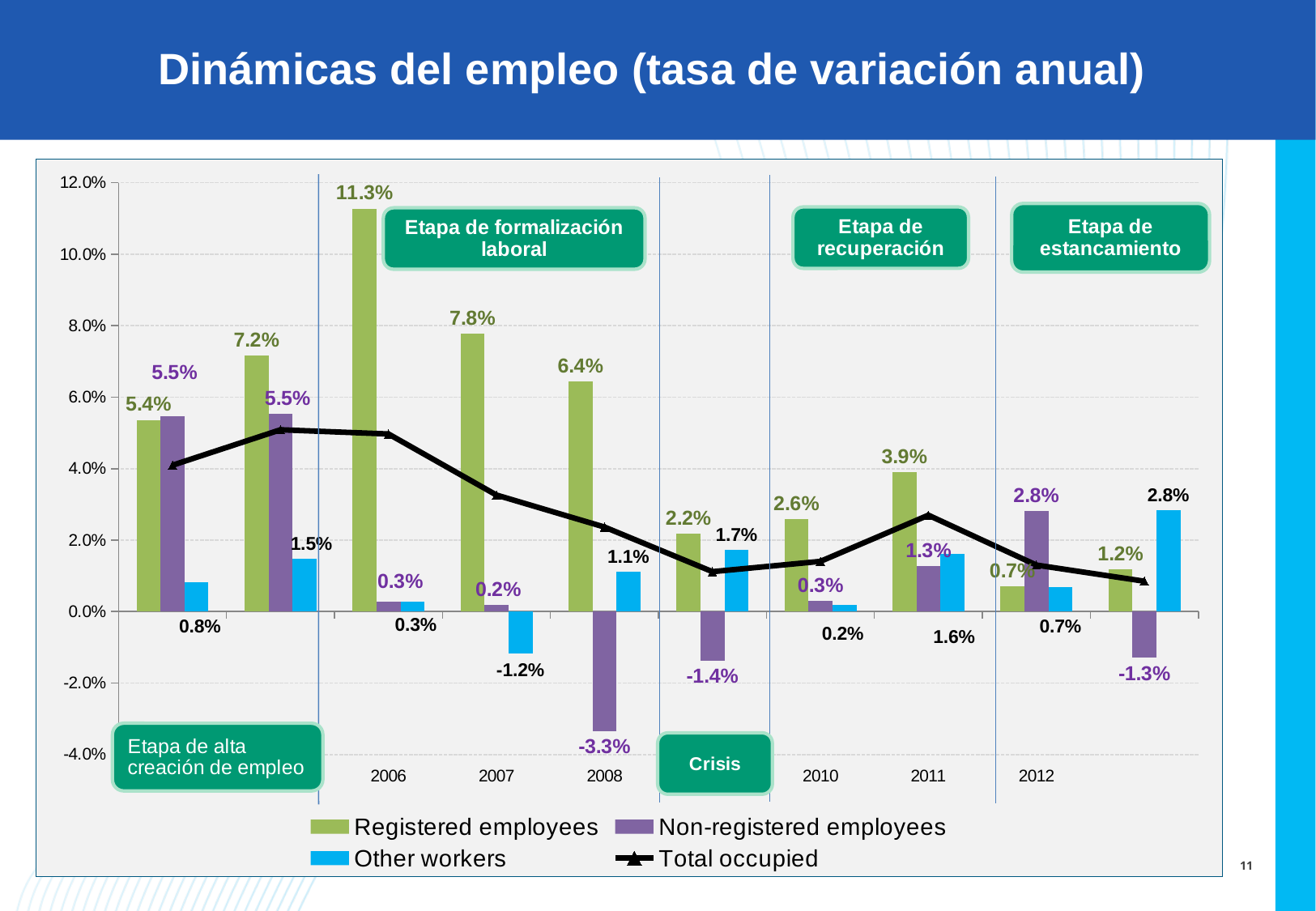
How many series does the legend list? 4 Is the Total occupied value in 2006 greater or less than 4.0%? greater Among the labelled years, in which year is the Non-registered employees value lowest? 2008 Which series is drawn as a black line with triangle markers? Total occupied What is the value for Non-registered employees in 2012? 2.8% Which is larger in 2011: Registered employees or Other workers? Registered employees What is the value for Registered employees in 2006? 11.3% What is the value for Other workers in 2007? -1.2% Among the labelled years, in which year is the Registered employees value highest? 2006 What is the value for Non-registered employees in 2008? -3.3% Do the Registered employees values rise or fall from 2006 to 2008? fall What is the difference between the Registered employees values in 2006 and 2007? 3.5%